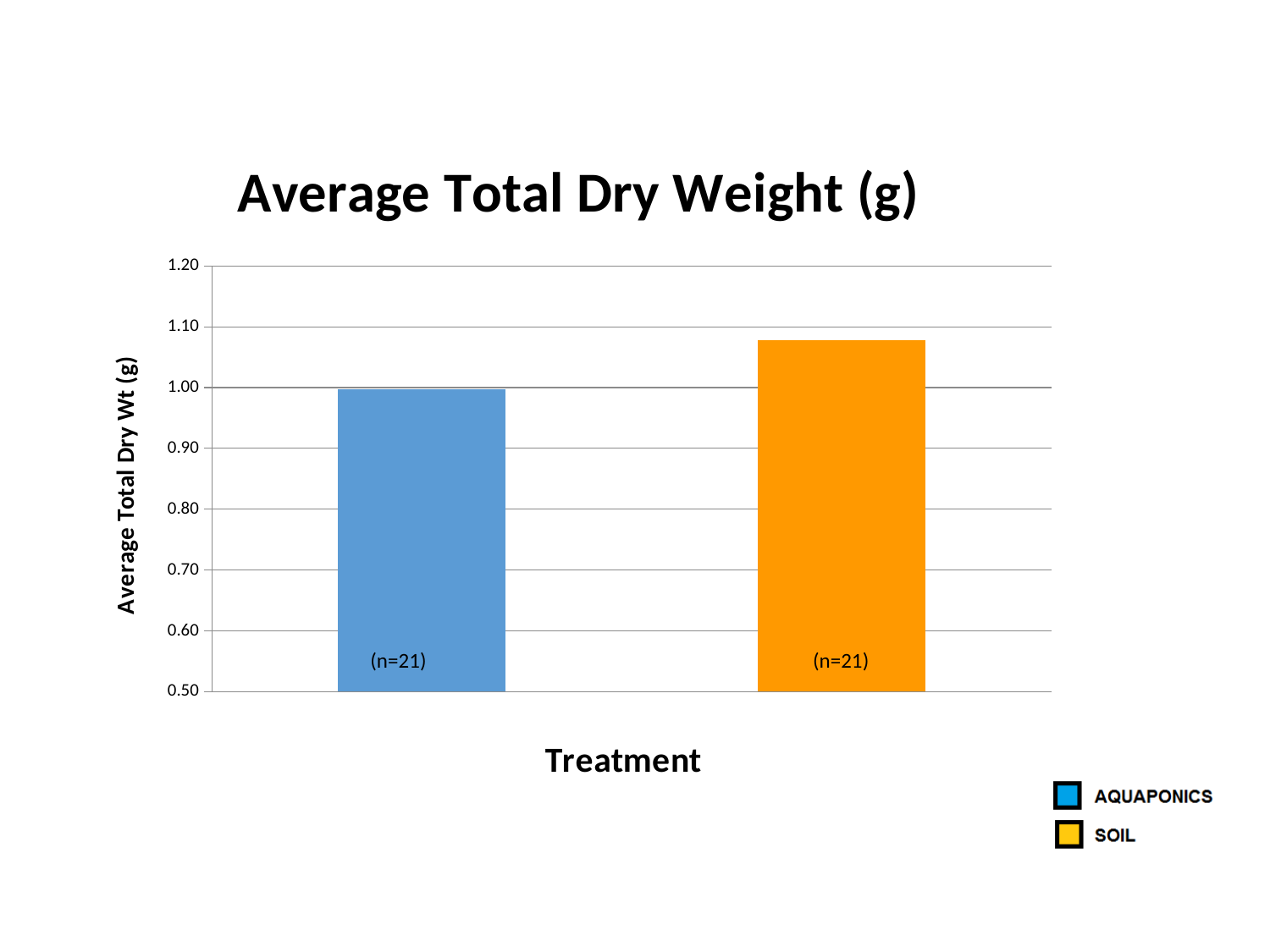
Is the value for AQUAPONICS greater or less than 0.90? greater Which treatment has the lowest average total dry weight? AQUAPONICS What sample size is printed on each bar? n=21 Is the value for SOIL greater or less than 1.00? greater Is the value for SOIL greater or less than 1.10? less How many entries does the legend list? 2 What kind of chart is shown on the slide? bar chart Which is larger, the average total dry weight for AQUAPONICS or for SOIL? SOIL What is the title of the chart? Average Total Dry Weight (g) How many bars are plotted in the chart? 2 Which treatment has the highest average total dry weight? SOIL